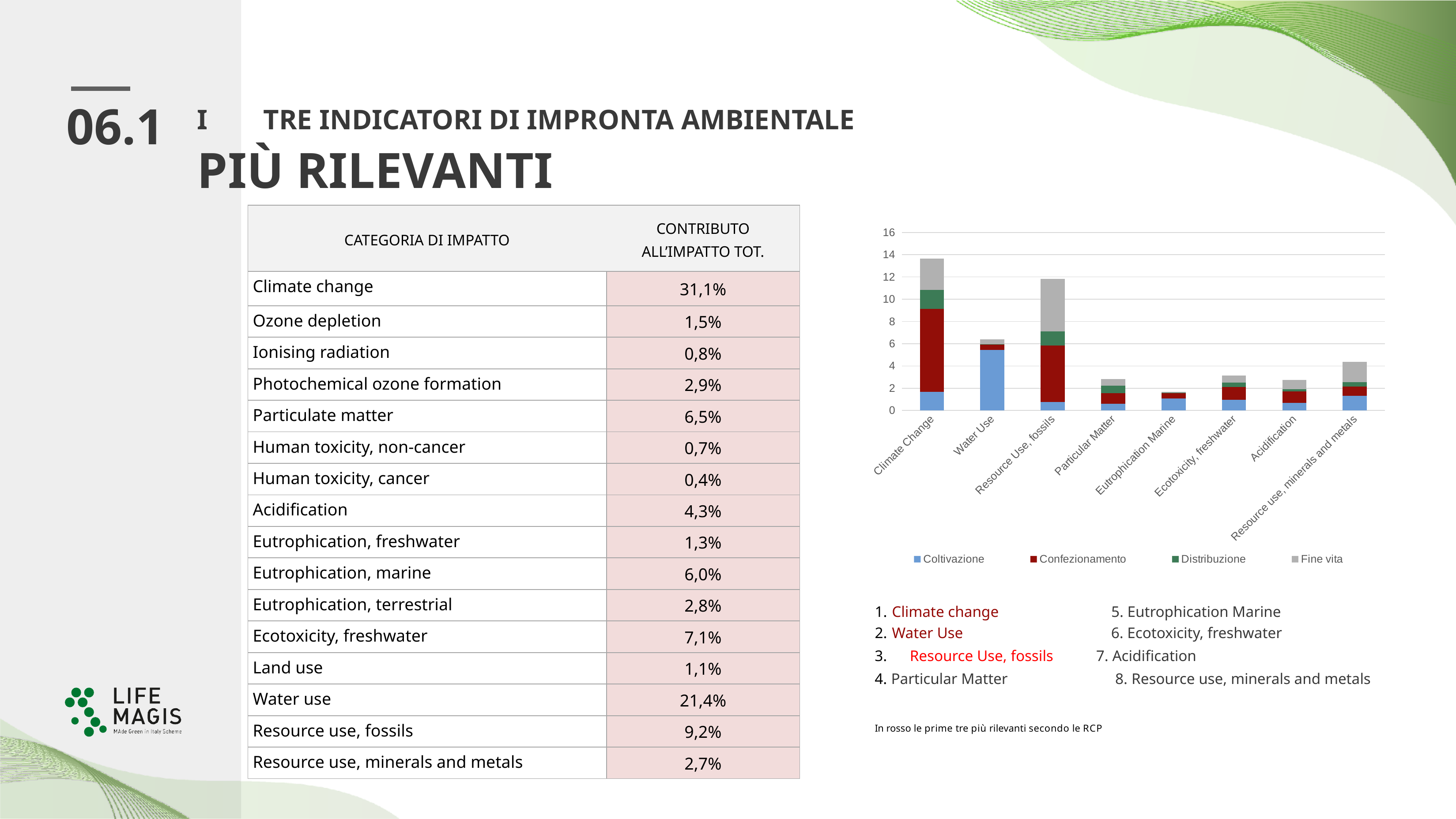
Is the total stacked value for Eutrophication Marine greater or less than 2? less Which series is shown in grey in the chart legend? Fine vita Which category has the shortest stacked bar in the chart? Eutrophication Marine Which stacked bar is taller, Water Use or Resource Use, fossils? Resource Use, fossils Which stacked bar is taller, Acidification or Resource use, minerals and metals? Resource use, minerals and metals Is the total stacked value for Climate Change greater or less than 12? greater How many impact categories are plotted along the x axis of the chart? 8 Which category has the tallest stacked bar in the chart? Climate Change How many series does the chart legend list? 4 Is the total stacked value for Particular Matter greater or less than 4? less What kind of chart is shown on the slide? Stacked bar chart